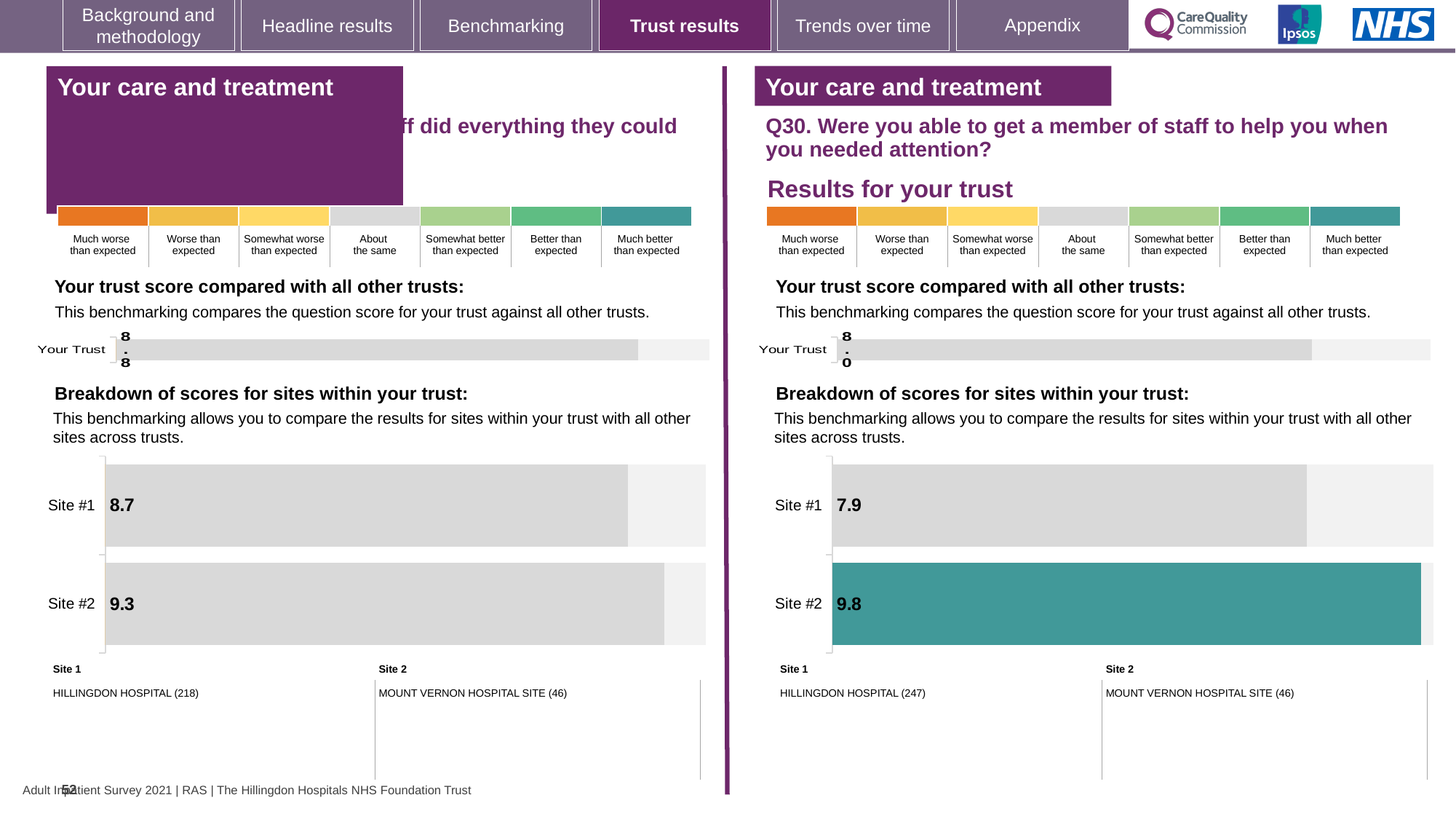
In the left-hand site breakdown chart, what is the difference between the Site #2 and Site #1 scores? 0.6 In the left-hand 'Breakdown of scores for sites within your trust' chart, what is the score for Site #2? 9.3 In the right-hand (Q30) site breakdown chart, which site has the higher score? Site #2 In the right-hand (Q30) site breakdown chart, what is the difference between the Site #2 and Site #1 scores? 1.9 In the right-hand (Q30) 'Your trust score compared with all other trusts' chart, what is the score shown for Your Trust? 8.0 In the left-hand 'Breakdown of scores for sites within your trust' chart, what is the score for Site #1? 8.7 What type of chart is used for the site breakdown on the right-hand (Q30) side of the slide? Bar chart In the left-hand 'Your trust score compared with all other trusts' chart, what is the score shown for Your Trust? 8.8 In the right-hand (Q30) 'Breakdown of scores for sites within your trust' chart, what is the score for Site #2? 9.8 How many sites are shown in the right-hand (Q30) site breakdown chart? 2 In the left-hand site breakdown chart, which site has the lower score? Site #1 In the right-hand (Q30) 'Breakdown of scores for sites within your trust' chart, what is the score for Site #1? 7.9